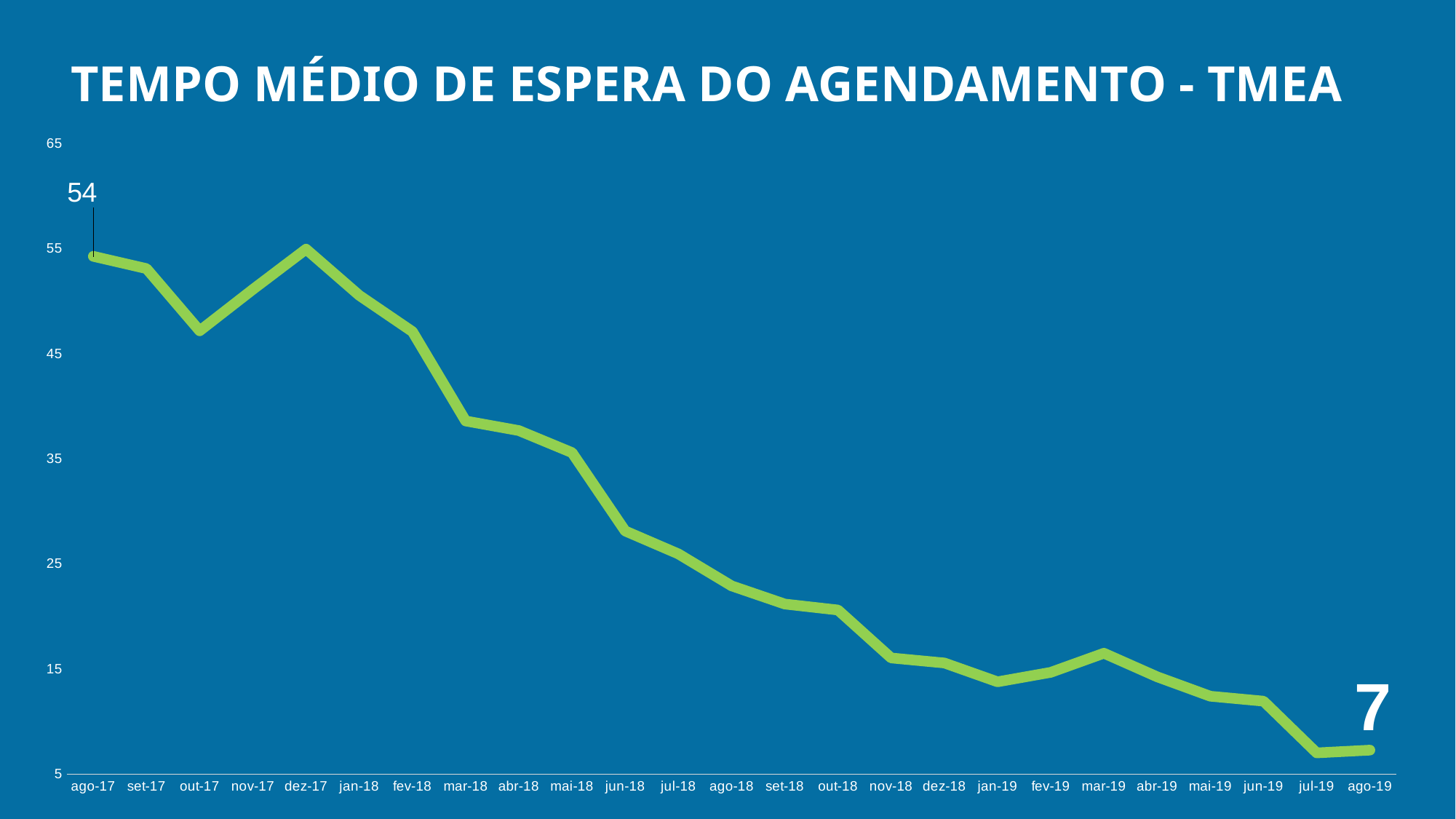
What is the value for ago-17? 54 Is the value for jan-19 greater or less than 15? less Is the value for mai-19 greater or less than 15? less Is the value for mar-18 greater or less than 35? greater How many months are plotted on the x axis? 25 Which is larger, the value for ago-17 or the value for ago-19? ago-17 What type of chart is shown on the slide? line chart What is the title of the chart? TEMPO MÉDIO DE ESPERA DO AGENDAMENTO - TMEA What is the value for ago-19? 7 What is the difference between the values for ago-17 and ago-19? 47 Do the values generally rise or fall from ago-17 to ago-19? fall